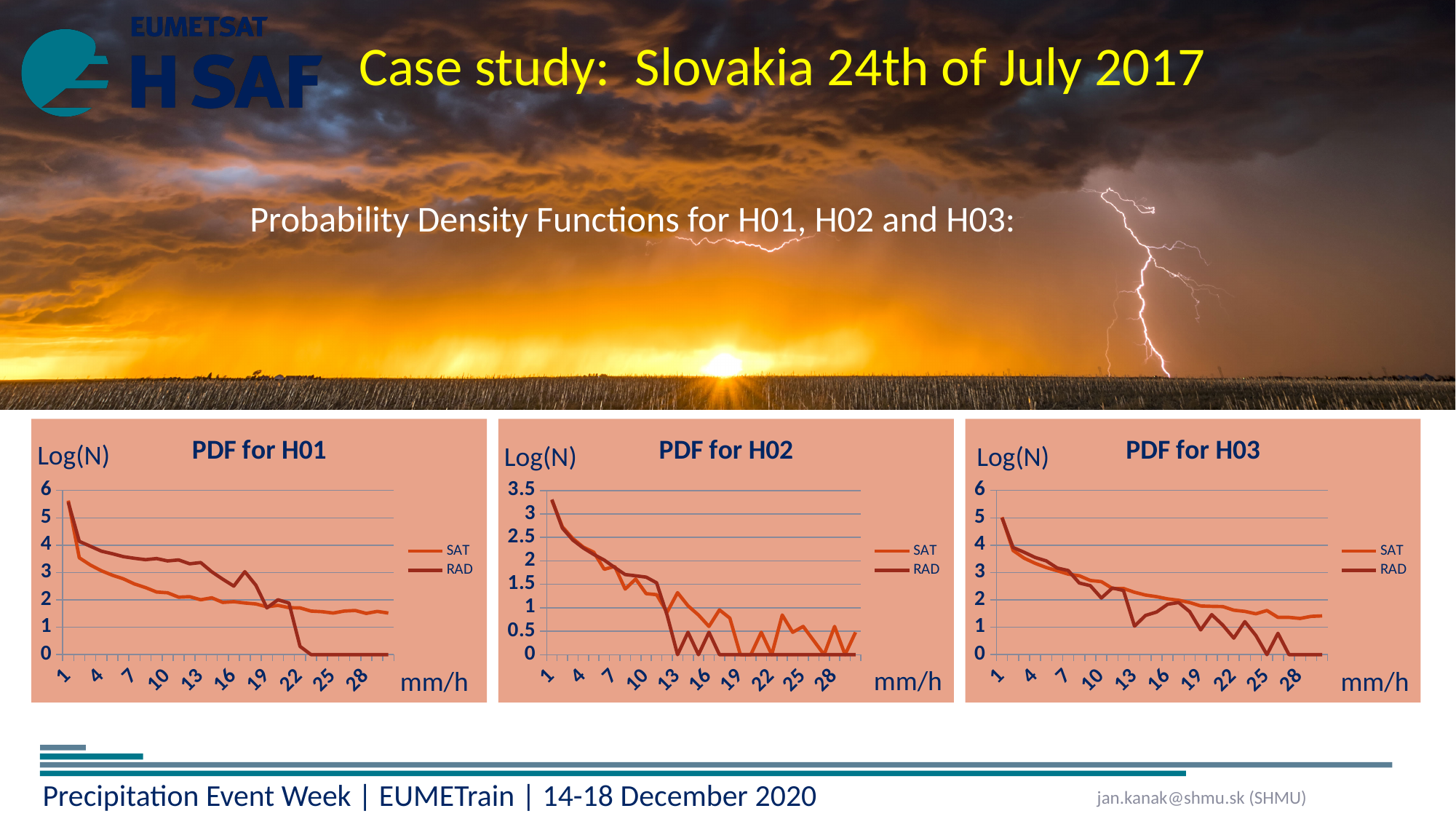
In "PDF for H02", is the SAT value at 13 mm/h greater or less than 1? greater In "PDF for H01", is the RAD value at 10 mm/h greater or less than 3? greater In "PDF for H03", which series has the larger value at 22 mm/h, SAT or RAD? SAT In "PDF for H03", is the SAT value at 10 mm/h greater or less than 2? greater What kind of chart is "PDF for H01"? line chart What is the label on the vertical axis of "PDF for H02"? Log(N) In "PDF for H03", do the values generally rise or fall as mm/h increases? fall How many series does the legend of "PDF for H02" list? 2 What unit is shown on the horizontal axis of "PDF for H03"? mm/h In "PDF for H01", which series has the larger value at 13 mm/h, SAT or RAD? RAD